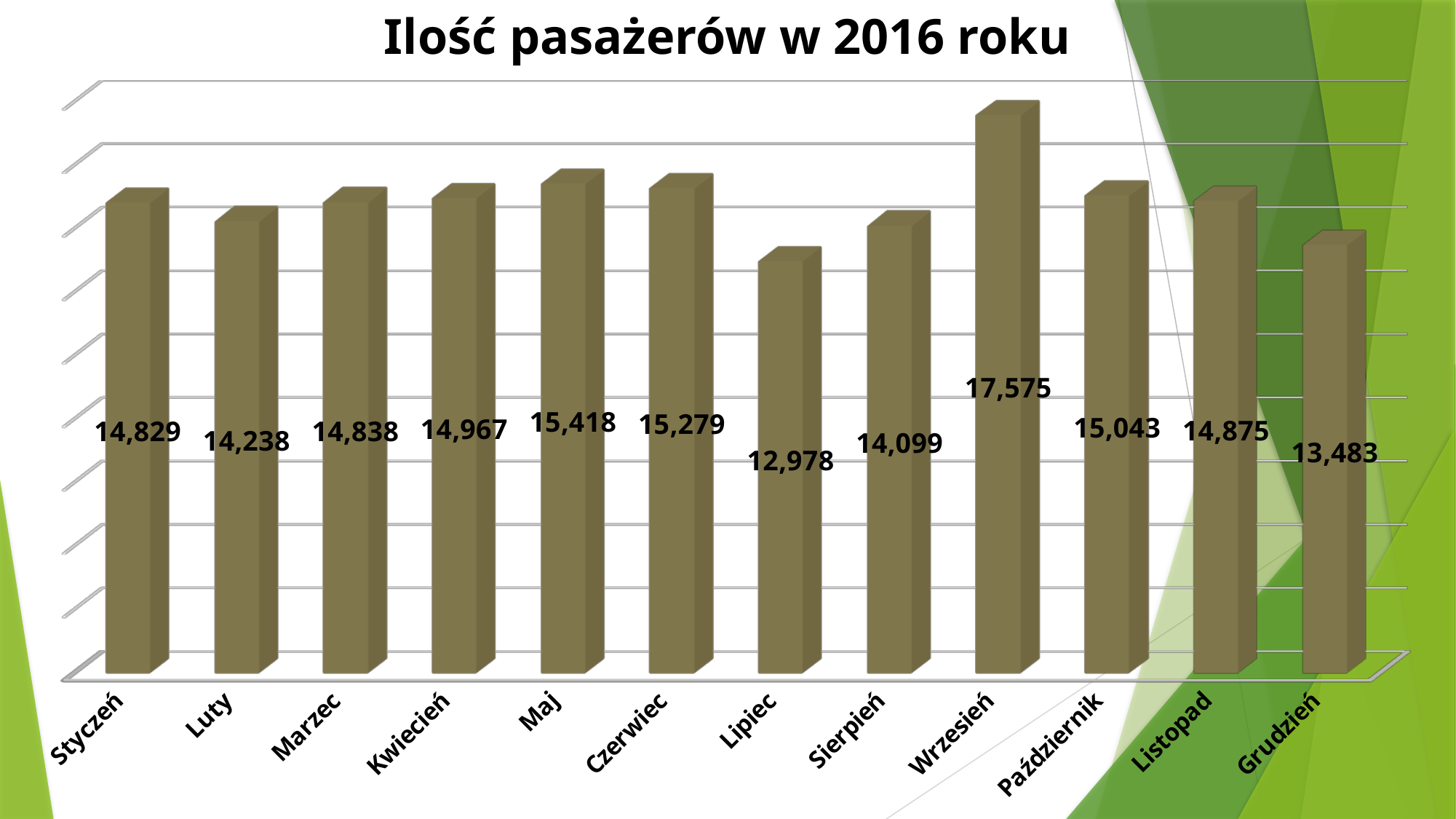
What value is shown for Maj? 15,418 What is the difference between the values for Wrzesień and Lipiec? 4,597 What value is shown for Grudzień? 13,483 What is the title of the chart? Ilość pasażerów w 2016 roku What is the number of passengers for Wrzesień? 17,575 Which month has the highest number of passengers? Wrzesień What is the number of passengers for Lipiec? 12,978 What is the difference between the values for Maj and Czerwiec? 139 Which month has the lowest number of passengers? Lipiec How many months are shown on the chart? 12 Which has a larger value, Maj or Czerwiec? Maj What kind of chart is this? Bar chart